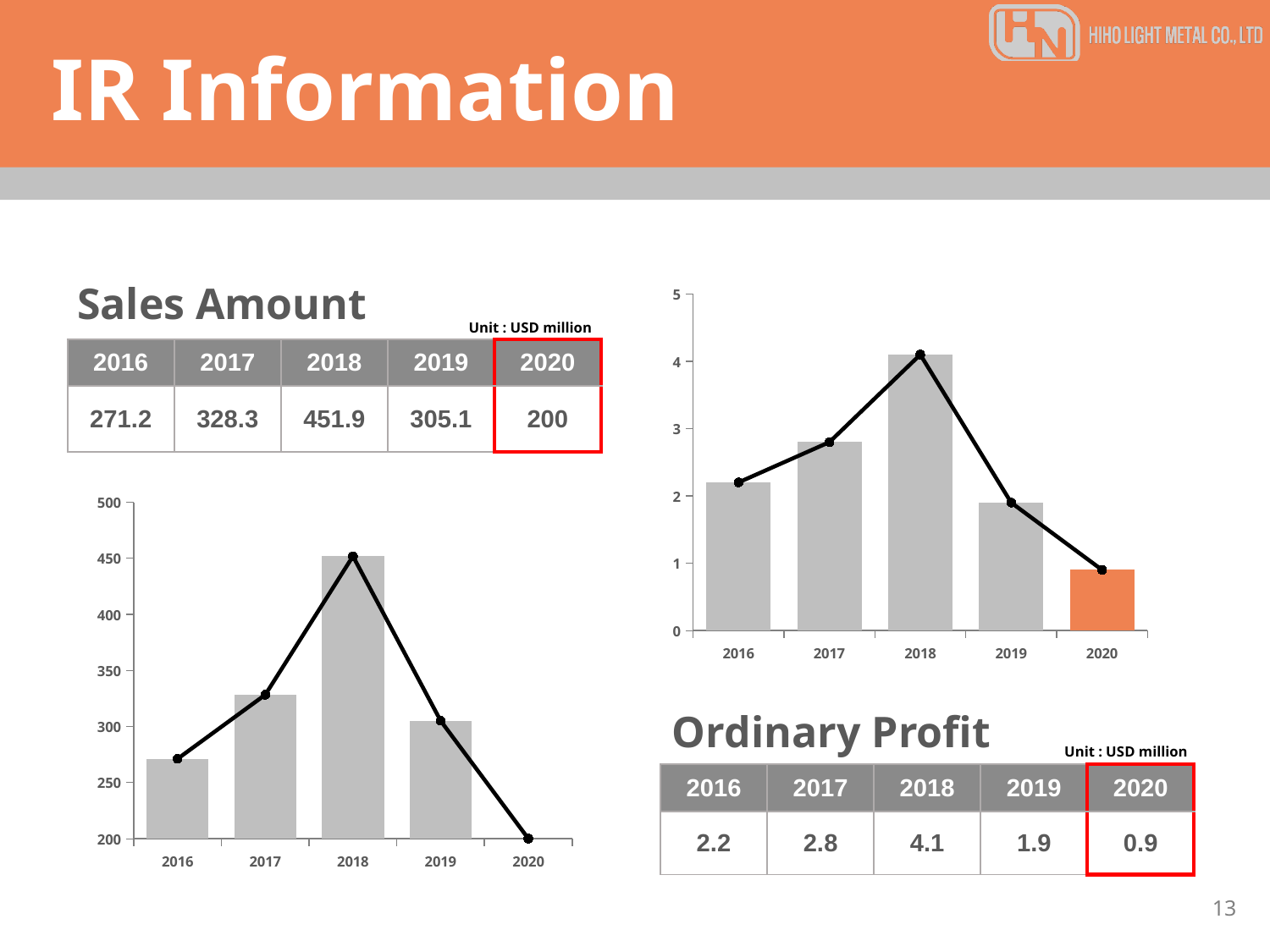
On the Ordinary Profit chart, do the values rise or fall from 2018 to 2020? fall On the Sales Amount chart, how many years are plotted? 5 On the Ordinary Profit chart, what is the difference between the 2017 and 2016 values? 0.6 On the Sales Amount chart, what is the difference between the 2018 and 2019 values? 146.8 On the Ordinary Profit chart, which year has the highest value? 2018 On the Ordinary Profit chart, what is the value for 2020? 0.9 On the Sales Amount chart, which year has the lowest value? 2020 On the Ordinary Profit chart, which year's bar is coloured orange? 2020 On the Sales Amount chart, which year has the highest value? 2018 On the Ordinary Profit chart, which is larger, the value for 2016 or the value for 2019? 2016 On the Sales Amount chart, what is the value for 2018? 451.9 On the Sales Amount chart, is the value for 2017 greater or less than 300? greater